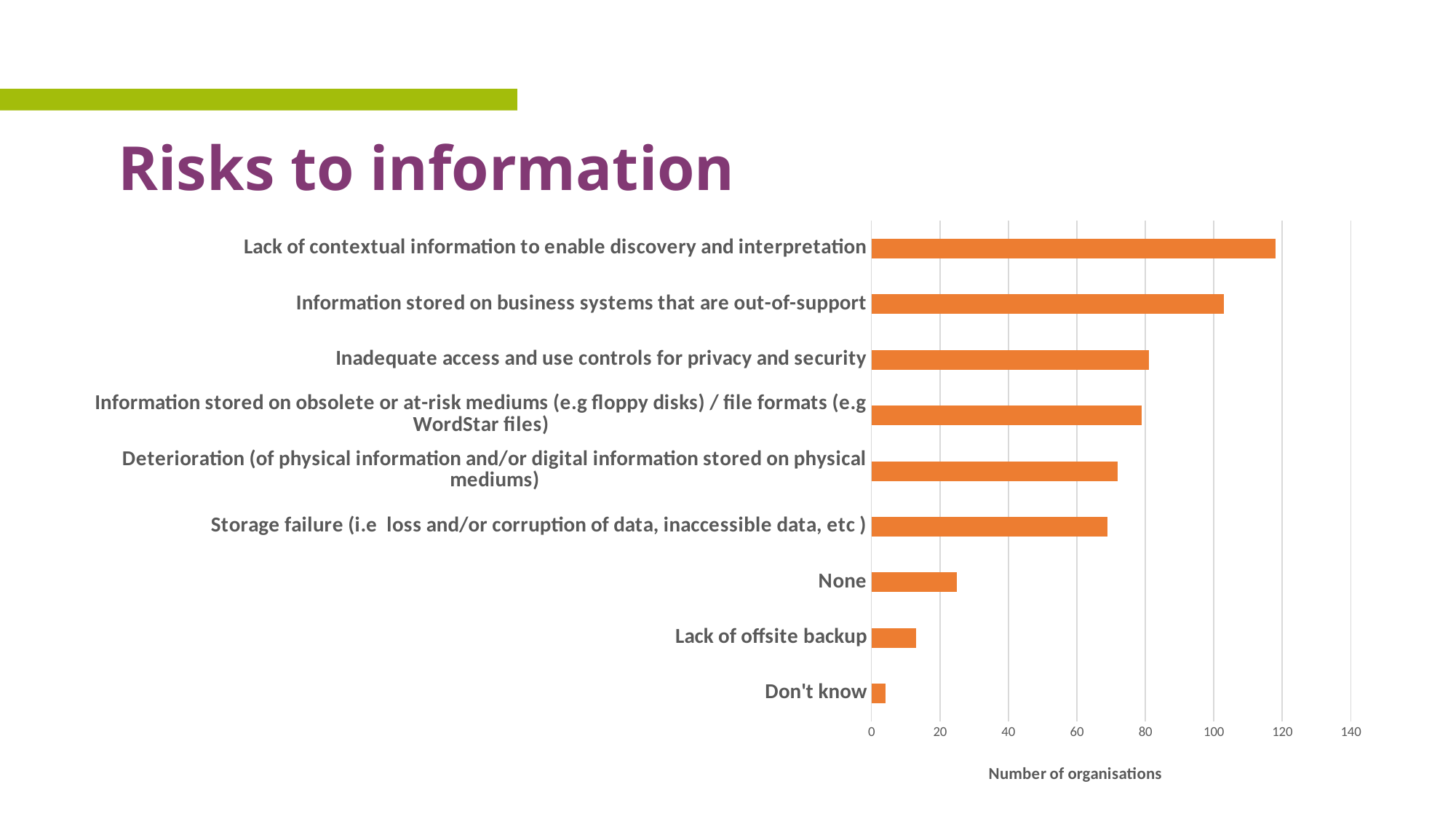
Is the value for 'Storage failure (i.e loss and/or corruption of data, inaccessible data, etc )' greater or less than 60? greater Is the value for 'None' greater or less than 40? less Is the value for 'Information stored on business systems that are out-of-support' greater or less than 120? less What is the label of the horizontal axis? Number of organisations Which category has the lowest number of organisations? Don't know Which has more organisations: 'None' or 'Lack of offsite backup'? None What kind of chart is shown on the slide? bar chart How many categories are plotted in the chart? 9 Which category has the highest number of organisations? Lack of contextual information to enable discovery and interpretation Which has more organisations: 'Inadequate access and use controls for privacy and security' or 'Storage failure (i.e loss and/or corruption of data, inaccessible data, etc )'? Inadequate access and use controls for privacy and security